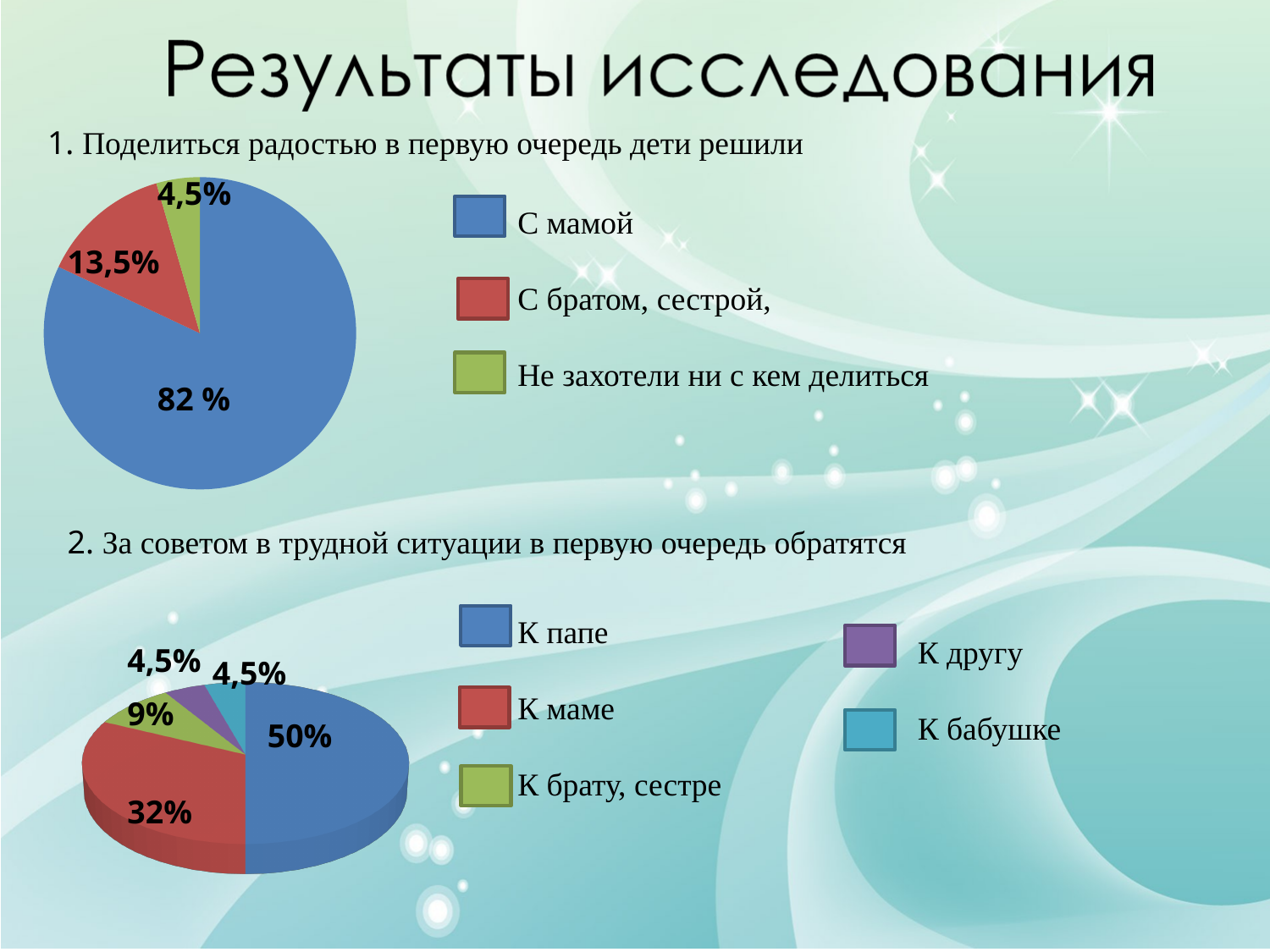
On the bottom pie chart, what is the difference between the shares for К папе and К маме? 18% On the bottom pie chart, how many categories does the legend list? 5 On the top pie chart, which category has the largest slice? С мамой On the bottom pie chart, what share is labelled for К маме? 32% What type of chart is the bottom chart on the slide? Pie chart On the top pie chart (Поделиться радостью в первую очередь дети решили), what share is labelled for С мамой? 82 % On the top pie chart, how many slices are there? 3 On the top pie chart, what share is labelled for С братом, сестрой? 13,5% On the bottom pie chart, what share is labelled for К брату, сестре? 9% On the top pie chart, what share is labelled for Не захотели ни с кем делиться? 4,5% On the bottom pie chart (За советом в трудной ситуации в первую очередь обратятся), what share is labelled for К папе? 50% On the top pie chart, which category has the smallest slice? Не захотели ни с кем делиться